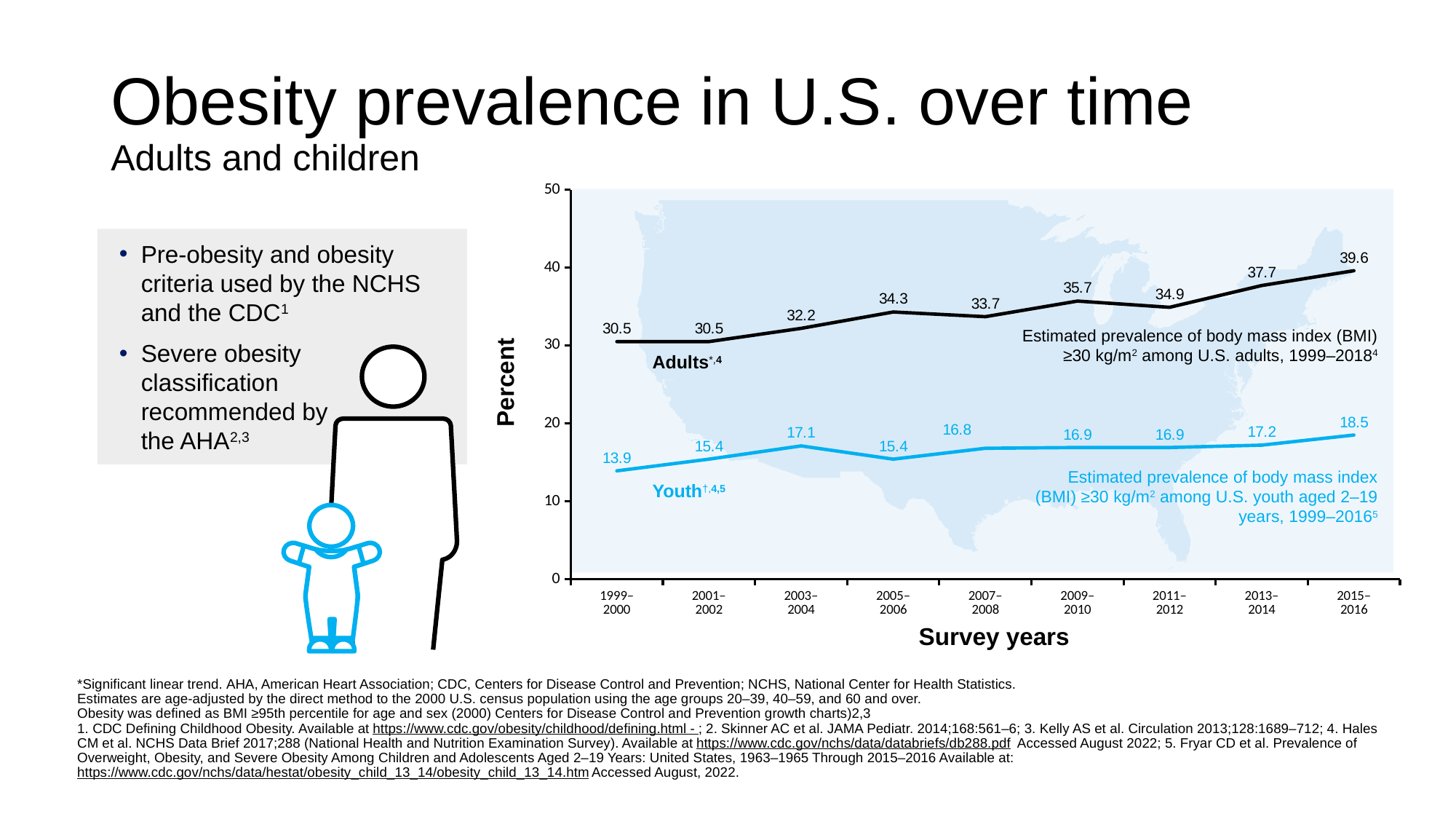
Which is larger, the adult value for 2009–2010 or the adult value for 2011–2012? 2009–2010 In which survey years is the youth value lowest? 1999–2000 What is the difference between the adult values for 2015–2016 and 1999–2000? 9.1 What is the label of the y axis? Percent What is the adult obesity prevalence value for the 2015–2016 survey years? 39.6 In which survey years is the youth value highest? 2015–2016 What is the adult value for the 2007–2008 survey years? 33.7 What is the youth obesity prevalence value for the 1999–2000 survey years? 13.9 How many survey-year periods are plotted on the x axis? 9 What kind of chart is shown on the slide? line chart Is the adult value for 2013–2014 greater or less than 40? less How many data series are plotted on the chart? 2